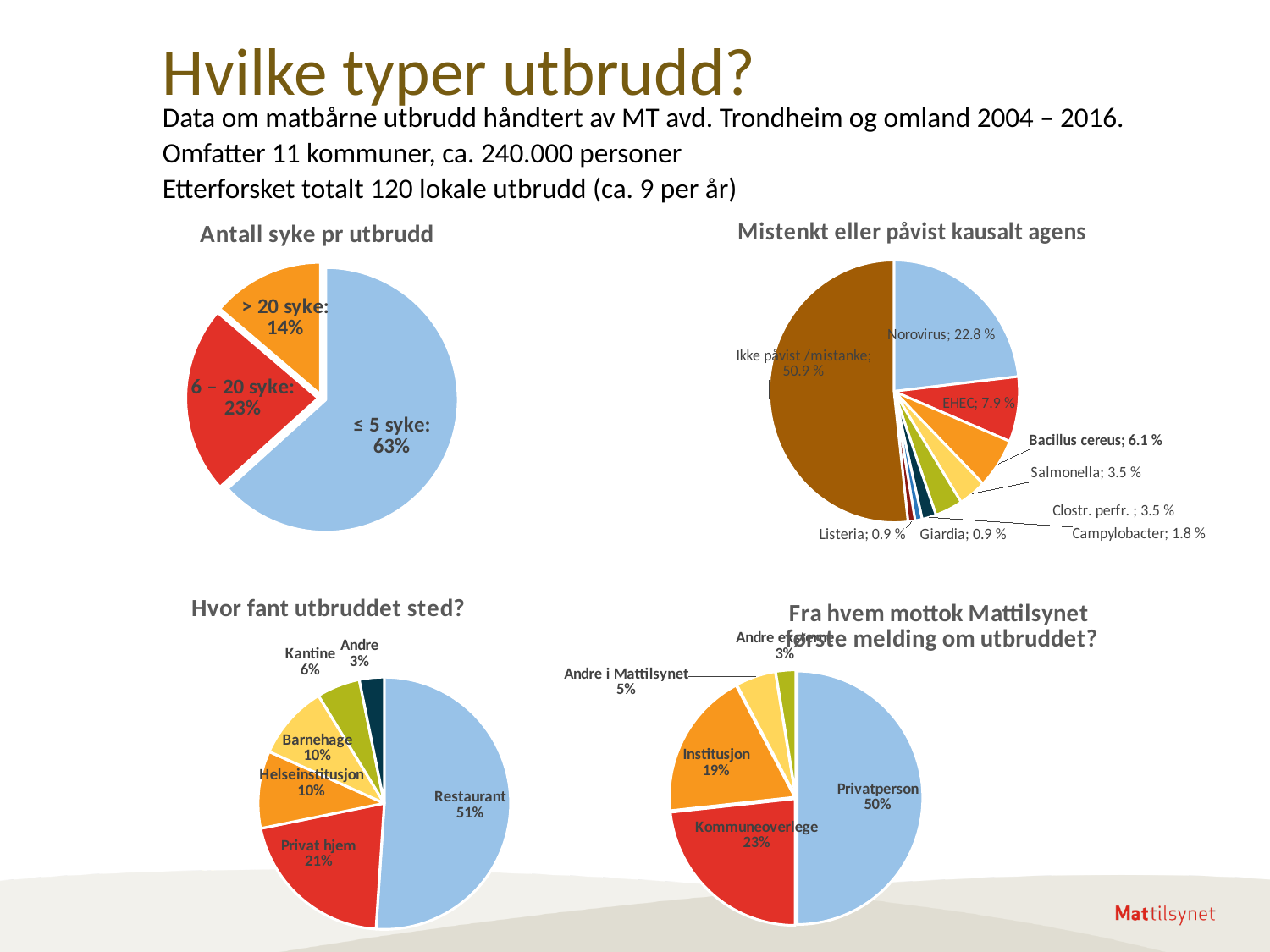
In the chart 'Antall syke pr utbrudd', what share of outbreaks had ≤ 5 syke? 63% In the chart 'Antall syke pr utbrudd', what is the difference between the shares for 6 – 20 syke and > 20 syke? 9% In the chart 'Mistenkt eller påvist kausalt agens', which category has the largest share? Ikke påvist /mistanke In the chart 'Mistenkt eller påvist kausalt agens', how many categories are shown? 9 In the chart 'Mistenkt eller påvist kausalt agens', what is the value for Norovirus? 22.8 % In the chart 'Mistenkt eller påvist kausalt agens', which is larger, EHEC or Bacillus cereus? EHEC In the chart 'Antall syke pr utbrudd', which category has the smallest share? > 20 syke In the chart 'Fra hvem mottok Mattilsynet første melding om utbruddet?', which category has the smallest share? Andre eksterne In the chart 'Fra hvem mottok Mattilsynet første melding om utbruddet?', what is the share for Kommuneoverlege? 23% In the chart 'Hvor fant utbruddet sted?', what is the difference between Restaurant and Privat hjem? 30% In the chart 'Hvor fant utbruddet sted?', what share of outbreaks took place in a Restaurant? 51% What type of chart is 'Hvor fant utbruddet sted?'? Pie chart